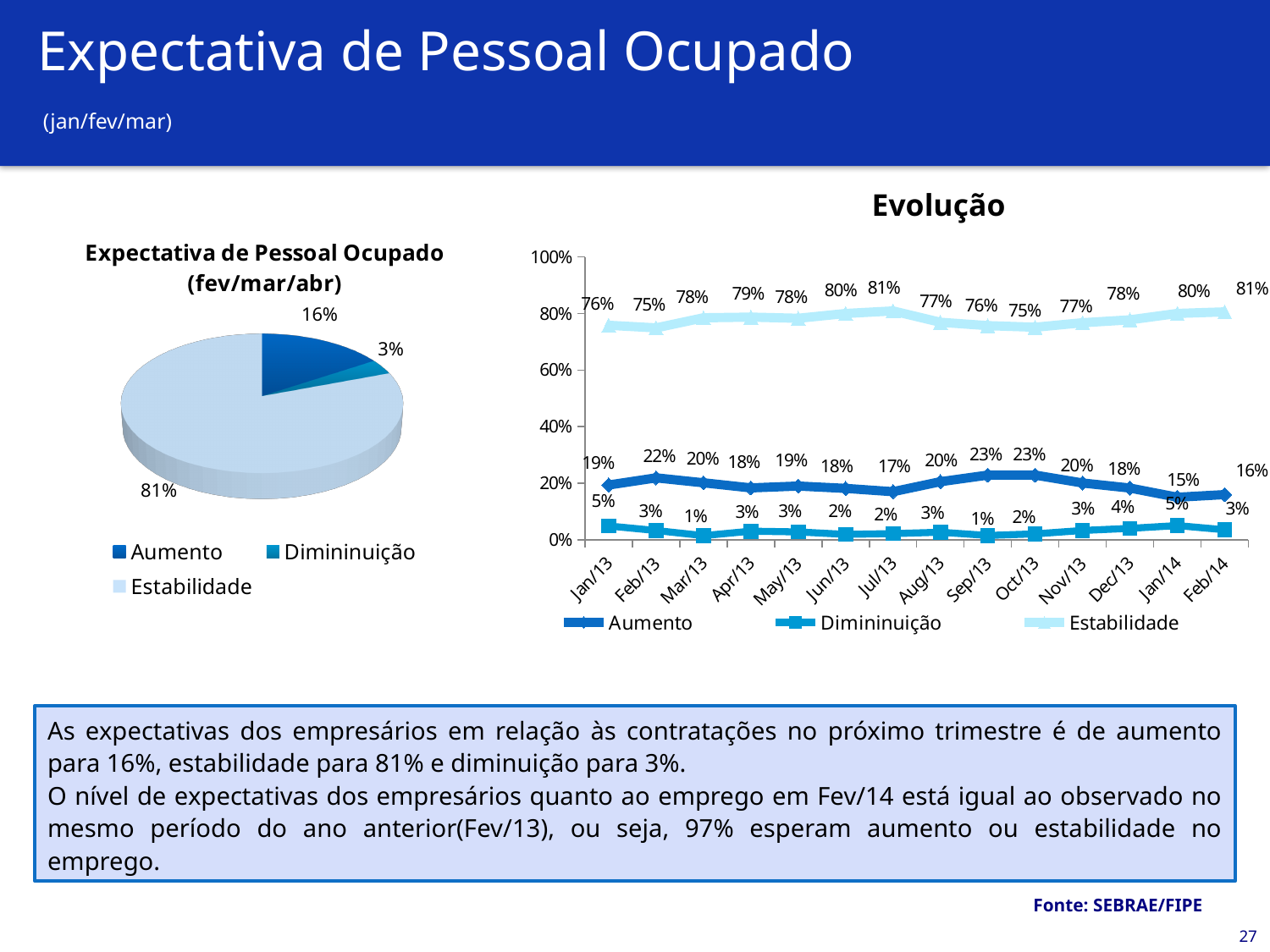
In the 'Evolução' chart, what is the value of Aumento in Feb/13? 22% In the 'Evolução' chart, is the value of Estabilidade in Apr/13 greater or less than 60%? greater In the 'Evolução' chart, what is the value of Estabilidade in Jul/13? 81% In the pie chart 'Expectativa de Pessoal Ocupado (fev/mar/abr)', which category has the smallest slice? Dimininuição In the 'Evolução' chart, in which month does Estabilidade reach its lowest value? Feb/13 and Oct/13 (75%) In the pie chart 'Expectativa de Pessoal Ocupado (fev/mar/abr)', what share is Aumento? 16% In the 'Evolução' chart, how many months are plotted on the x axis? 14 In the pie chart 'Expectativa de Pessoal Ocupado (fev/mar/abr)', what share is Estabilidade? 81% What kind of chart is the 'Evolução' chart? Line chart In the pie chart 'Expectativa de Pessoal Ocupado (fev/mar/abr)', how many categories does the legend list? 3 In the 'Evolução' chart, what is the value of Diminuição in Jan/14? 5% In the 'Evolução' chart, what is the difference between Aumento in Sep/13 and Aumento in Jan/14? 8%